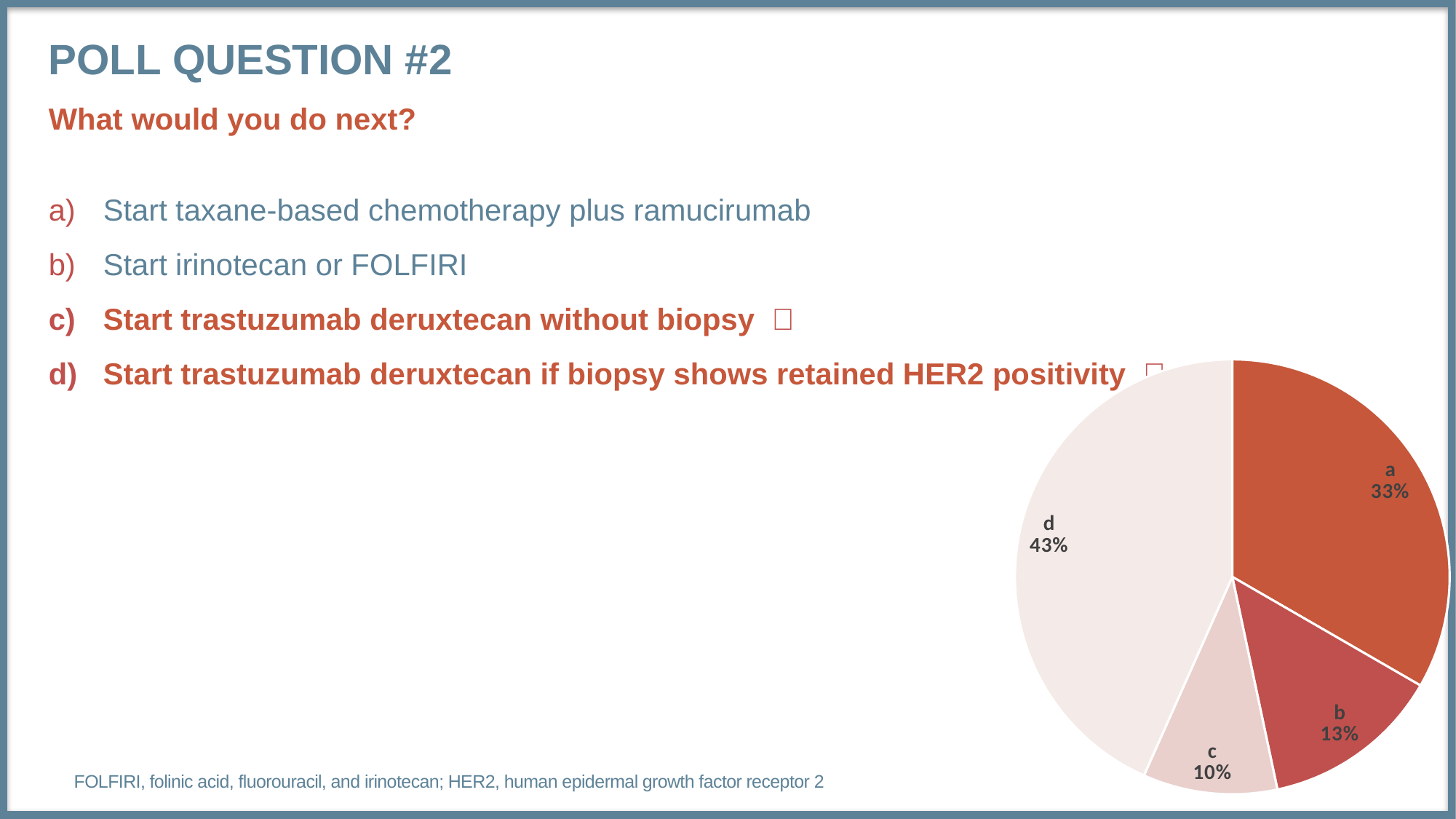
How many slices does the pie chart have? 4 What percentage of respondents chose option d? 43% What percentage of respondents chose option b? 13% Which option received the largest share of responses? d What kind of chart is shown on the slide? pie chart What is the difference in percentage points between option d and option a? 10 What percentage of respondents chose option c? 10% Which option received the smallest share of responses? c Which received a larger share of responses, option b or option c? b What percentage of respondents chose option a? 33% What is the difference in percentage points between option a and option b? 20 Which slice of the pie chart is the lightest in colour? d